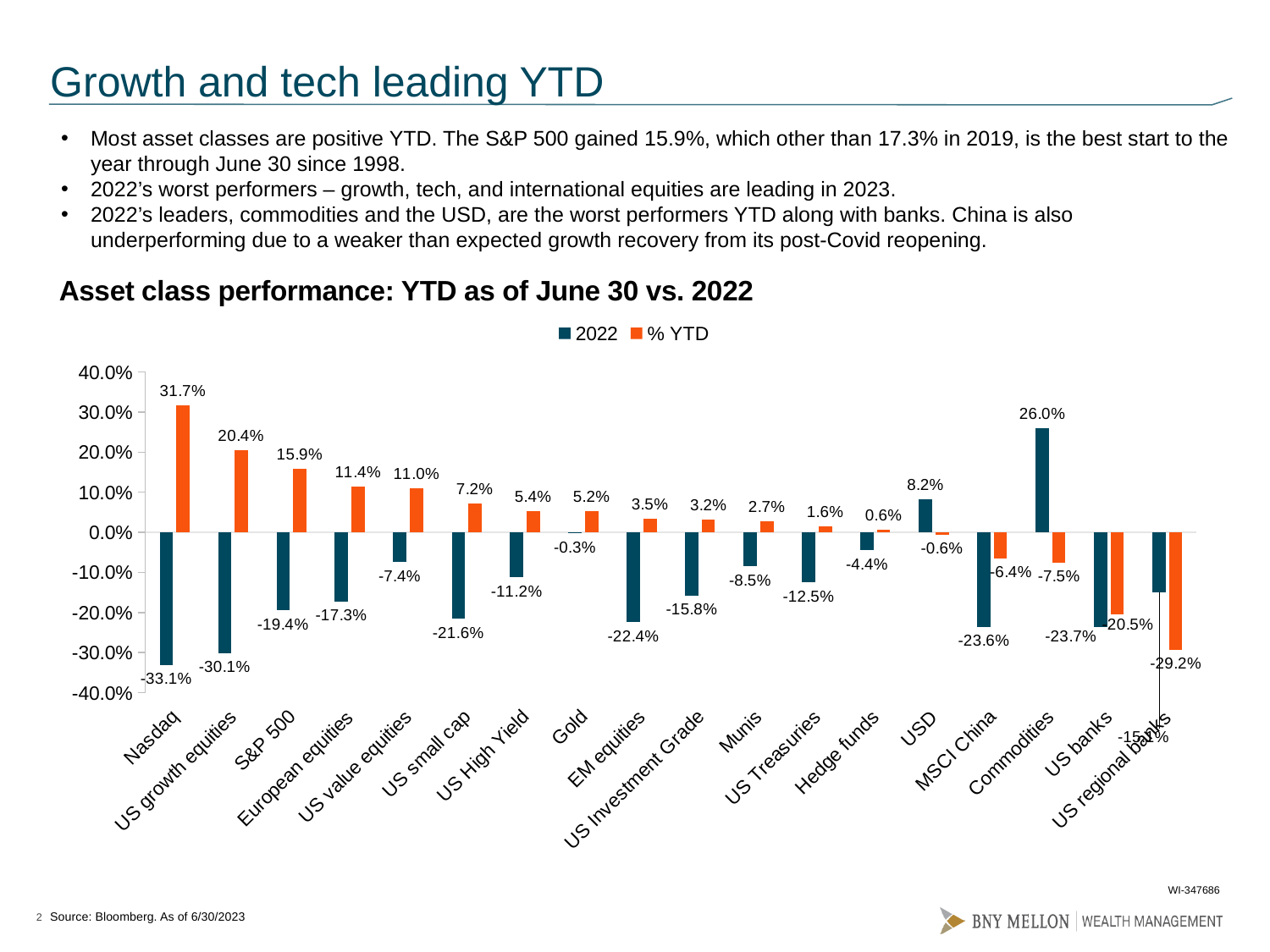
How many series does the legend list? 2 What kind of chart is shown on the slide? Bar chart Which asset class has the highest % YTD value? Nasdaq What is the % YTD value for USD? -0.6% How many asset classes are shown on the x axis? 18 What is the 2022 value for Commodities? 26.0% Which has the larger 2022 value, Commodities or USD? Commodities Which asset class has the lowest % YTD value? US regional banks Is the 2022 value for MSCI China greater or less than -20.0%? less What is the % YTD value for the S&P 500? 15.9% Which asset class has the lowest 2022 value? Nasdaq What is the difference between the % YTD values for Nasdaq and US growth equities? 11.3 percentage points